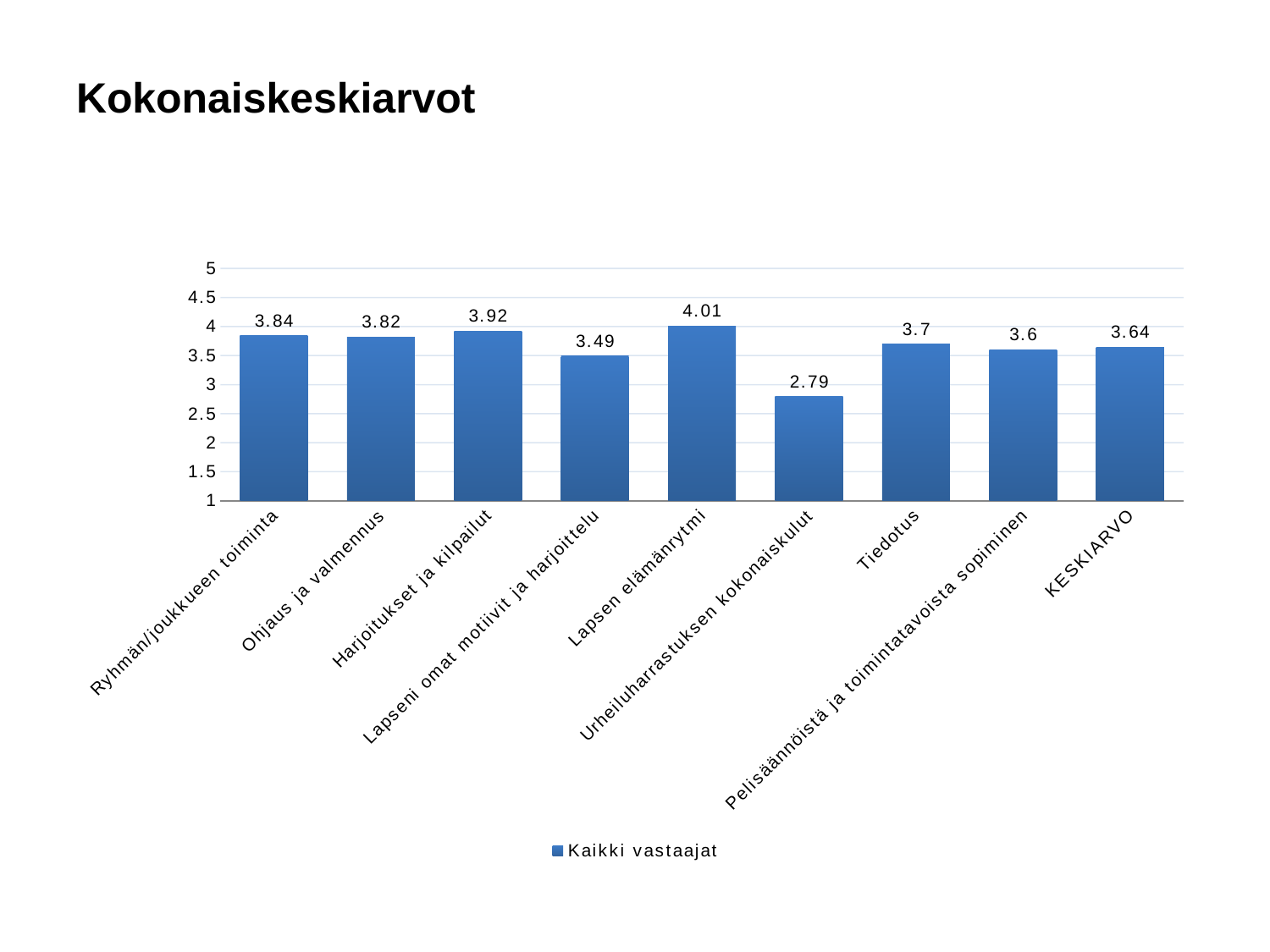
What is the value for KESKIARVO? 3.64 Is the value for Urheiluharrastuksen kokonaiskulut greater or less than 3? less What is the value for Tiedotus? 3.7 What is the value for Lapsen elämänrytmi? 4.01 Which category has the highest value? Lapsen elämänrytmi What series does the legend list? Kaikki vastaajat What is the value for Urheiluharrastuksen kokonaiskulut? 2.79 How many categories are shown on the x axis? 9 What is the difference between the values for Lapsen elämänrytmi and Urheiluharrastuksen kokonaiskulut? 1.22 Which is larger, the value for Harjoitukset ja kilpailut or the value for Lapseni omat motiivit ja harjoittelu? Harjoitukset ja kilpailut What kind of chart is shown on the slide? bar chart Which category has the lowest value? Urheiluharrastuksen kokonaiskulut